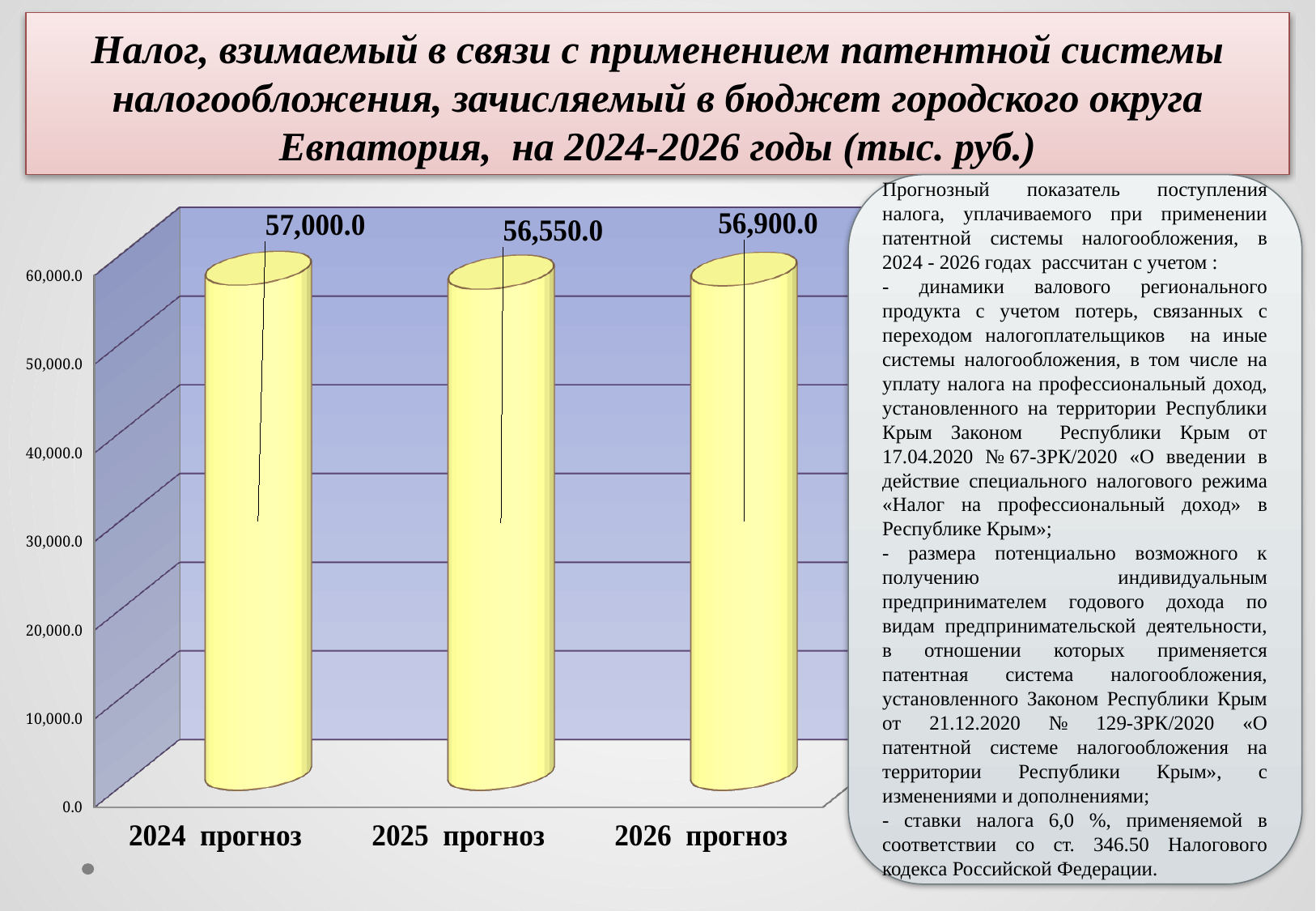
What is the value for 2025 прогноз? 56,550.0 What is the value for 2026 прогноз? 56,900.0 Which year has the highest value? 2024 прогноз What kind of chart is shown on the slide? bar chart Which year has the lowest value? 2025 прогноз Does the value fall or rise from 2024 прогноз to 2025 прогноз? fall What is the difference between the values for 2026 прогноз and 2025 прогноз? 350.0 What is the difference between the values for 2024 прогноз and 2025 прогноз? 450.0 What is the value for 2024 прогноз? 57,000.0 Which is larger, the value for 2024 прогноз or 2026 прогноз? 2024 прогноз How many categories are shown on the x axis? 3 Is the value for 2025 прогноз greater or less than 50,000.0? greater